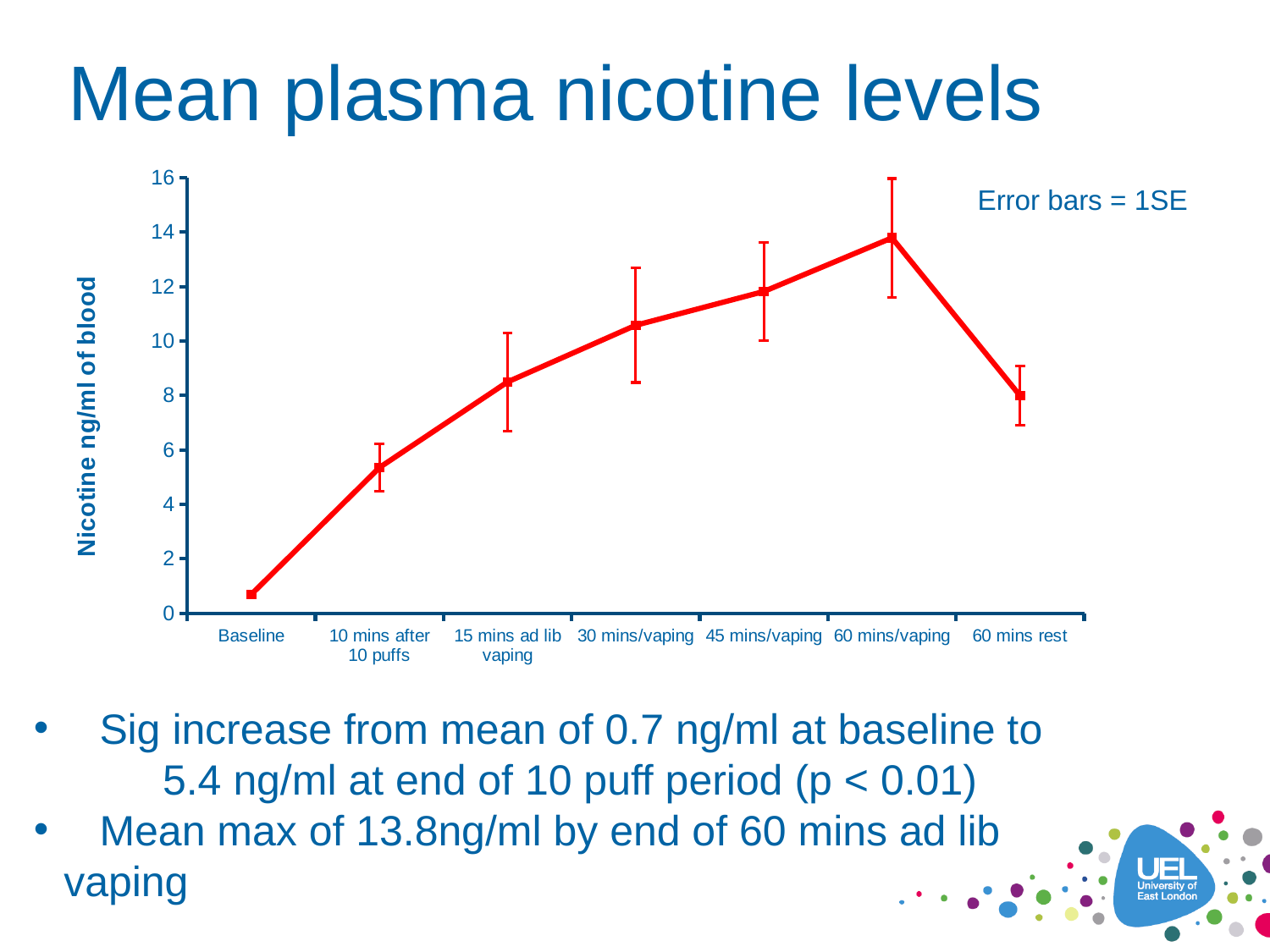
At which time point is the mean plasma nicotine level highest? 60 mins/vaping Is the value for 15 mins ad lib vaping greater or less than 10? less What do the error bars on the chart represent? 1SE What is the mean maximum plasma nicotine level reached at 60 mins/vaping? 13.8ng/ml What is the mean plasma nicotine level 10 mins after 10 puffs? 5.4 ng/ml What is the difference between the mean nicotine level at 60 mins/vaping (13.8 ng/ml) and at Baseline (0.7 ng/ml)? 13.1 ng/ml At which time point is the mean plasma nicotine level lowest? Baseline Which is larger, the value at 30 mins/vaping or the value at 60 mins rest? 30 mins/vaping What kind of chart is shown on the slide? line chart What is the mean plasma nicotine level at Baseline? 0.7 ng/ml How many time points are plotted on the chart? 7 Is the value for 30 mins/vaping greater or less than 10? greater